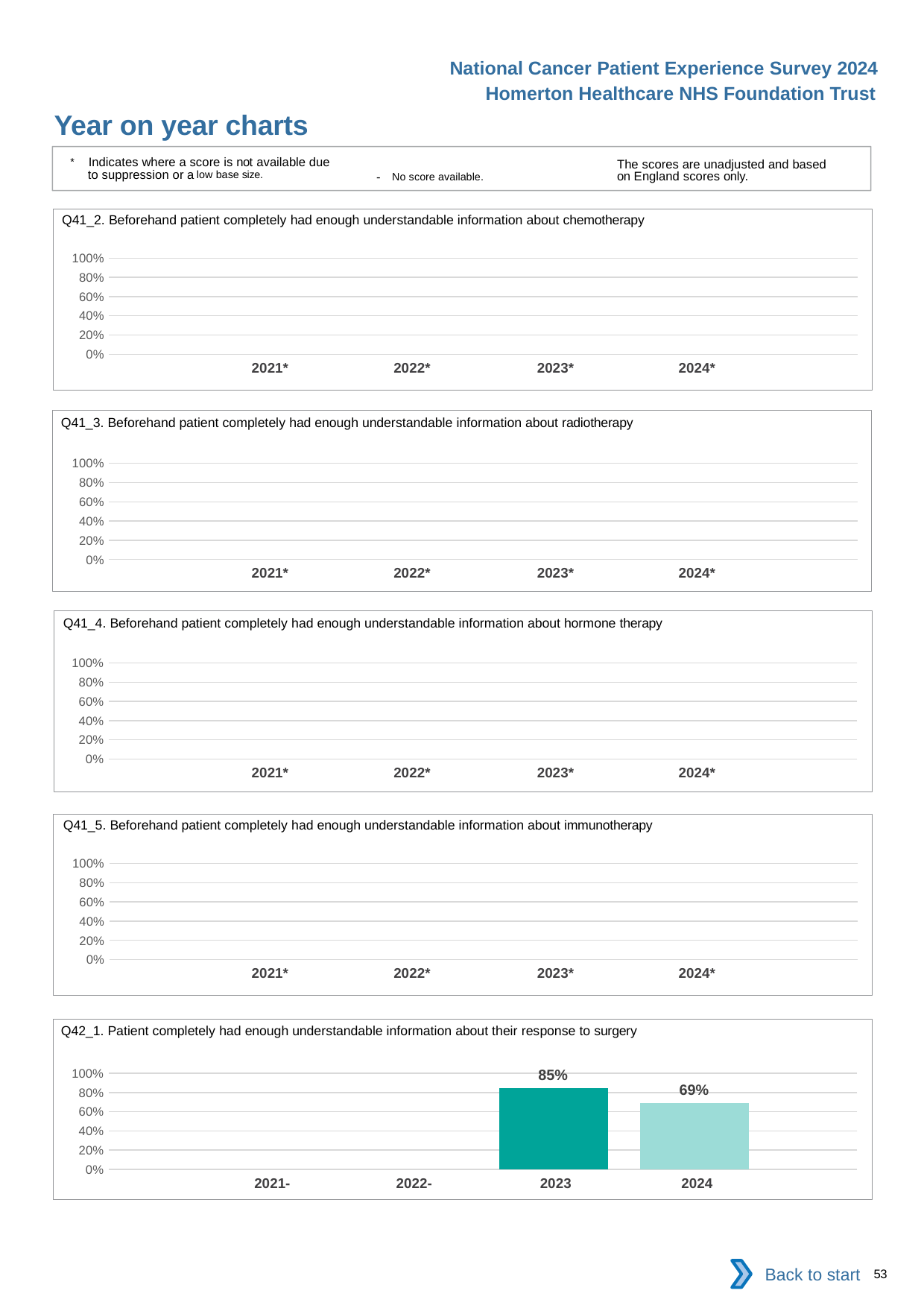
In the Q42_1 chart, which year has the highest value? 2023 How many charts are shown on the slide? 5 In the Q42_1 chart, how many years have a bar plotted? 2 In the Q42_1 chart, do the values rise or fall from 2023 to 2024? fall How many year categories are shown on the x axis of the Q42_1 chart? 4 In the Q41_2 chart, how many year categories are shown on the x axis? 4 In the Q42_1 chart, what is the difference between the 2023 and 2024 values? 16 percentage points In the Q42_1 chart, is the value for 2024 greater or less than 80%? less What kind of chart is the Q42_1 chart? bar chart In the Q42_1 chart, which is larger, the value for 2023 or the value for 2024? 2023 In the Q42_1 chart, what is the value for 2023? 85% In the Q42_1 chart, what is the value for 2024? 69%